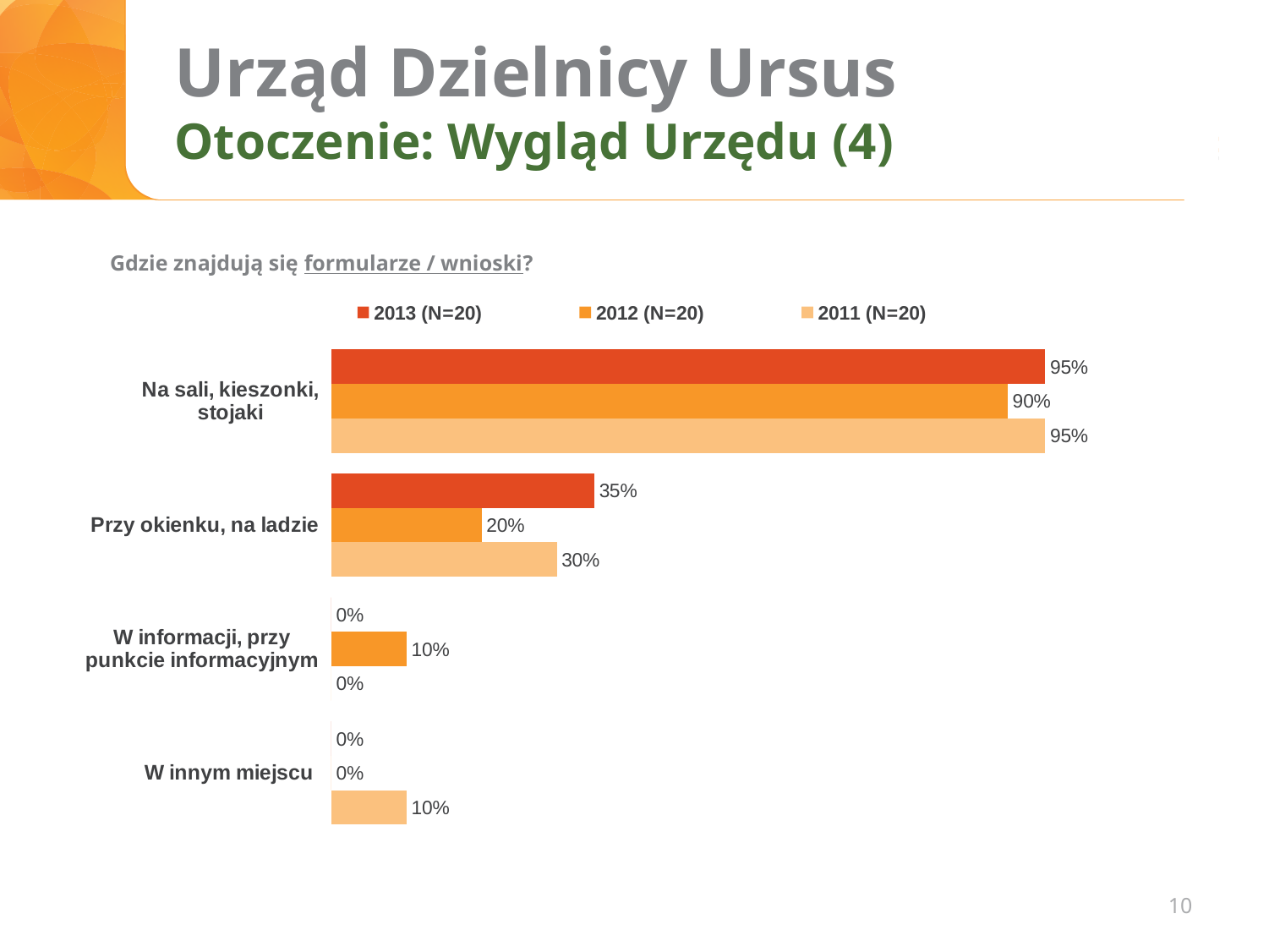
What is the value for 'Na sali, kieszonki, stojaki' in the 2013 (N=20) series? 95% Which category has the highest value in the 2013 (N=20) series? Na sali, kieszonki, stojaki How many series does the legend list? 3 What kind of chart is shown on the slide? Bar chart What question does the chart answer, as stated above it? Gdzie znajdują się formularze / wnioski? What is the difference between the 2013 (N=20) and 2012 (N=20) values for 'Na sali, kieszonki, stojaki'? 5% What is the value for 'W informacji, przy punkcie informacyjnym' in the 2012 (N=20) series? 10% What is the value for 'Przy okienku, na ladzie' in the 2012 (N=20) series? 20% How many categories are shown on the chart? 4 For 'Przy okienku, na ladzie', which is larger: the 2011 (N=20) value or the 2012 (N=20) value? 2011 (N=20) What is the value for 'W innym miejscu' in the 2011 (N=20) series? 10% What is the difference between the 2013 (N=20) and 2012 (N=20) values for 'Przy okienku, na ladzie'? 15%